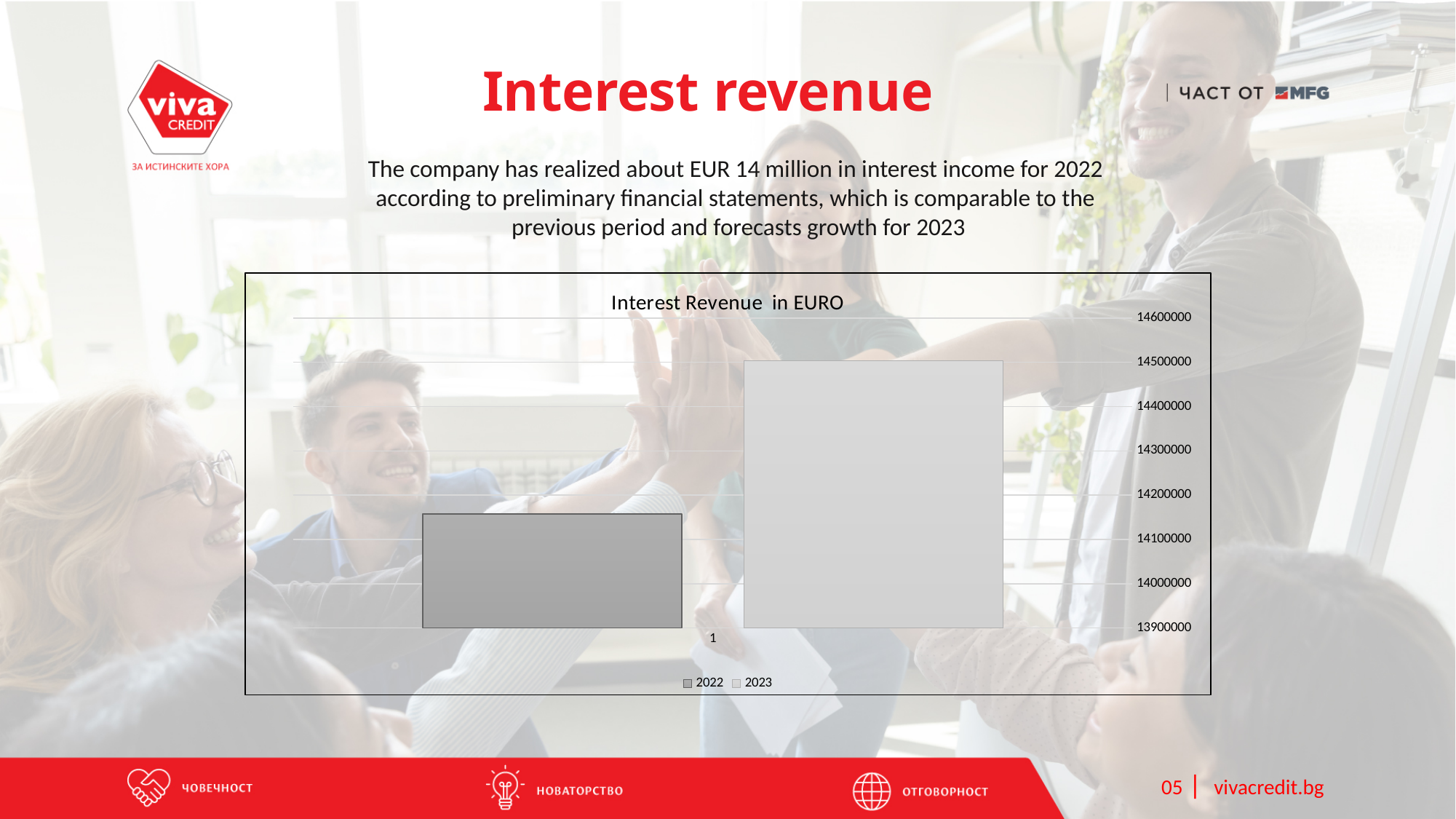
What is the title of the chart? Interest Revenue in EURO Is the value for 2023 greater or less than 14600000? less How many series does the chart legend list? 2 Which series has the shortest bar in the chart? 2022 Which series has the tallest bar in the chart? 2023 Is the value for 2023 greater or less than 14400000? greater Which series are listed in the chart legend? 2022 and 2023 Does interest revenue rise or fall from 2022 to 2023? rise What kind of chart is shown on the slide? bar chart Is the value for 2022 greater or less than 14100000? greater Which series has the higher bar, 2022 or 2023? 2023